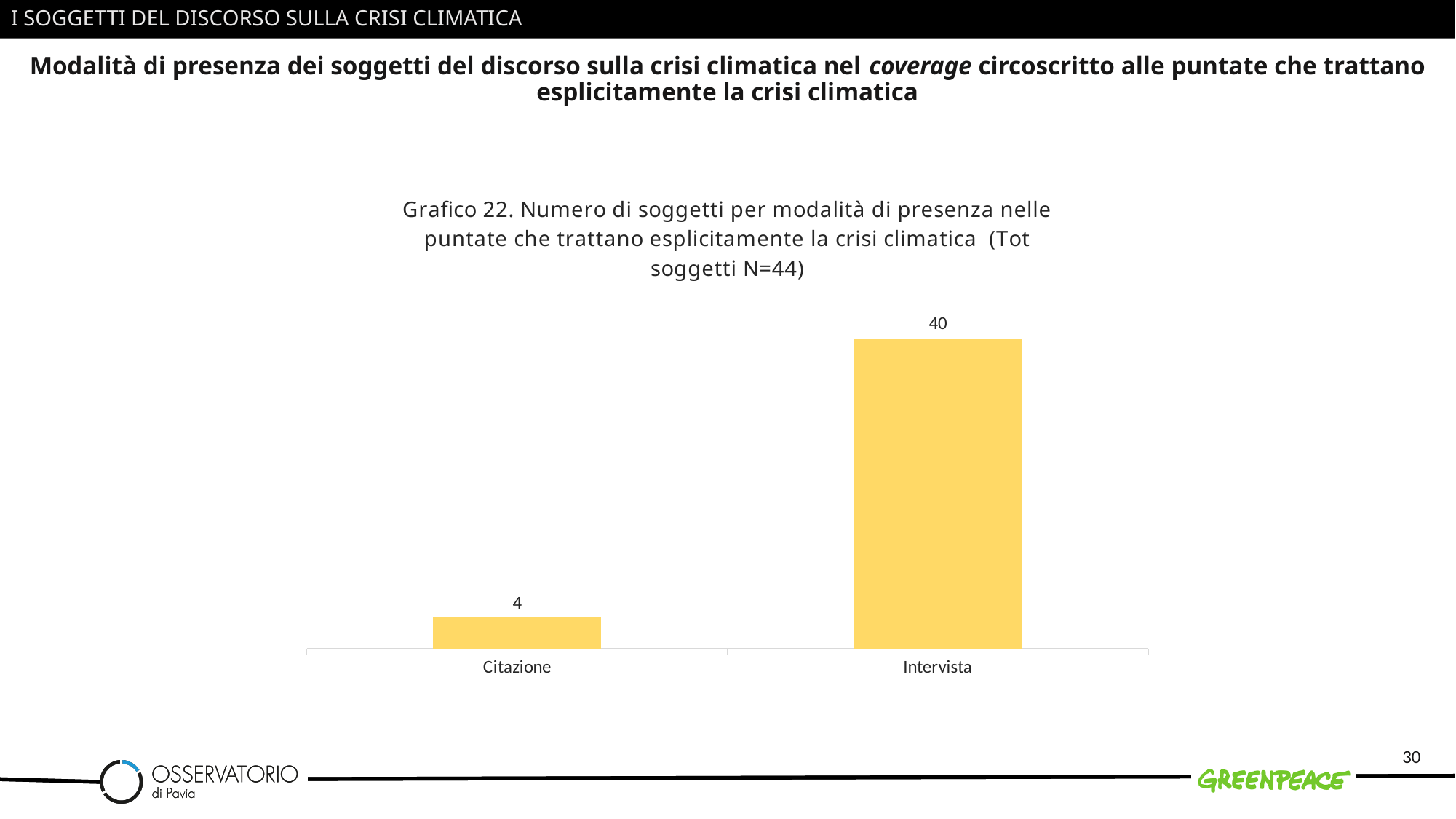
Which category has the lowest value? Citazione How many categories are shown on the x axis? 2 What is the difference between the values for Intervista and Citazione? 36 What is the value for Citazione? 4 What is the total of the two plotted values? 44 What colour are the bars in the chart? Yellow What kind of chart is shown on the slide? Bar chart Which is larger, the value for Citazione or the value for Intervista? Intervista What is the value for Intervista? 40 Which category has the highest value? Intervista What is the total number of subjects (N) stated in the chart title? 44